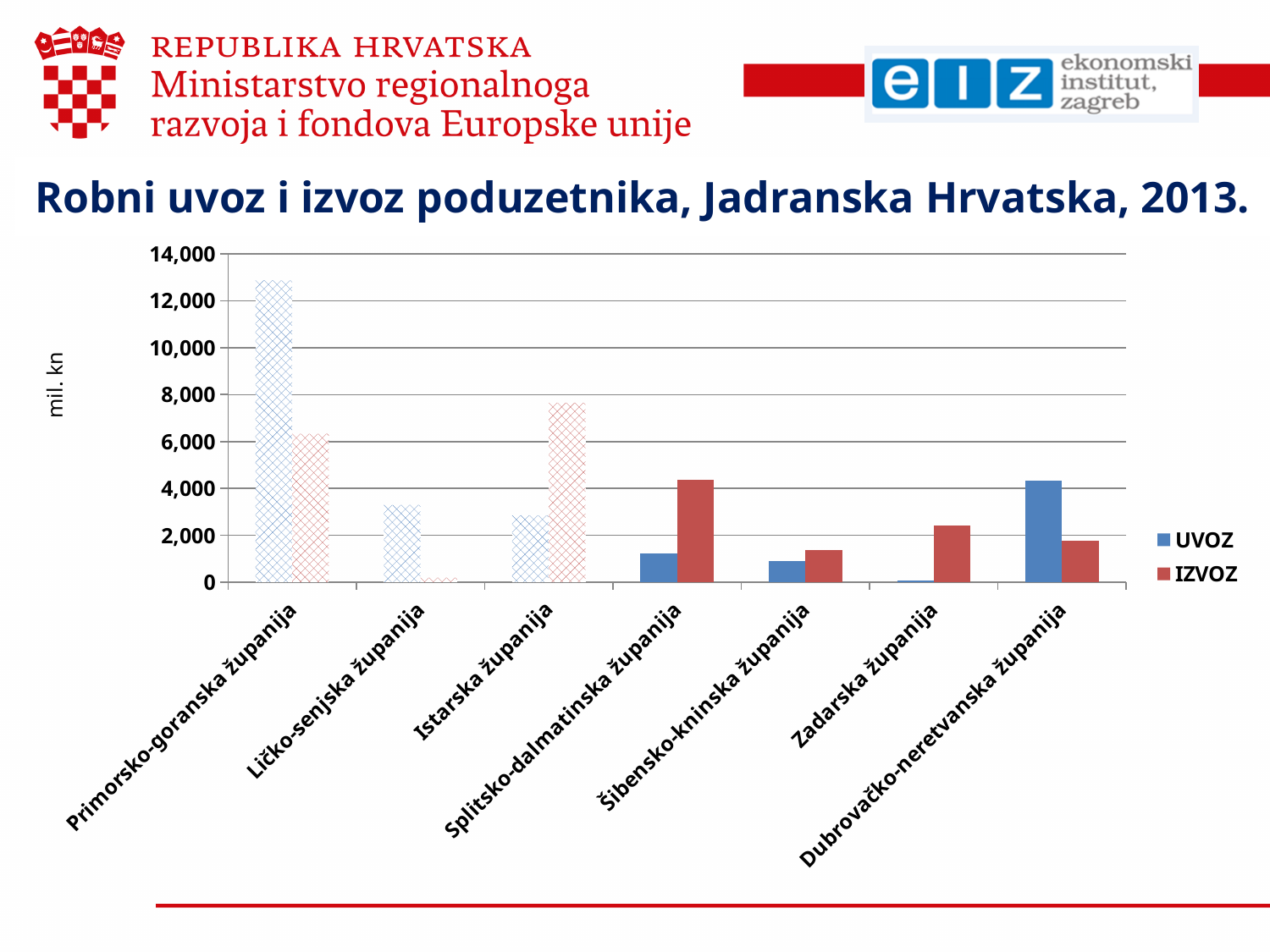
Which county has the highest IZVOZ value? Istarska županija Is the UVOZ value for Primorsko-goranska županija greater or less than 12,000? greater For Dubrovačko-neretvanska županija, which is larger, UVOZ or IZVOZ? UVOZ Which county has the highest UVOZ value? Primorsko-goranska županija Which county has the lowest UVOZ value? Zadarska županija For Istarska županija, which is larger, UVOZ or IZVOZ? IZVOZ How many counties (županije) are shown on the x axis? 7 Which county has the lowest IZVOZ value? Ličko-senjska županija How many series does the legend list? 2 Is the IZVOZ value for Istarska županija greater or less than 8,000? less What kind of chart is shown on the slide? bar chart What unit is shown on the y axis of the chart? mil. kn